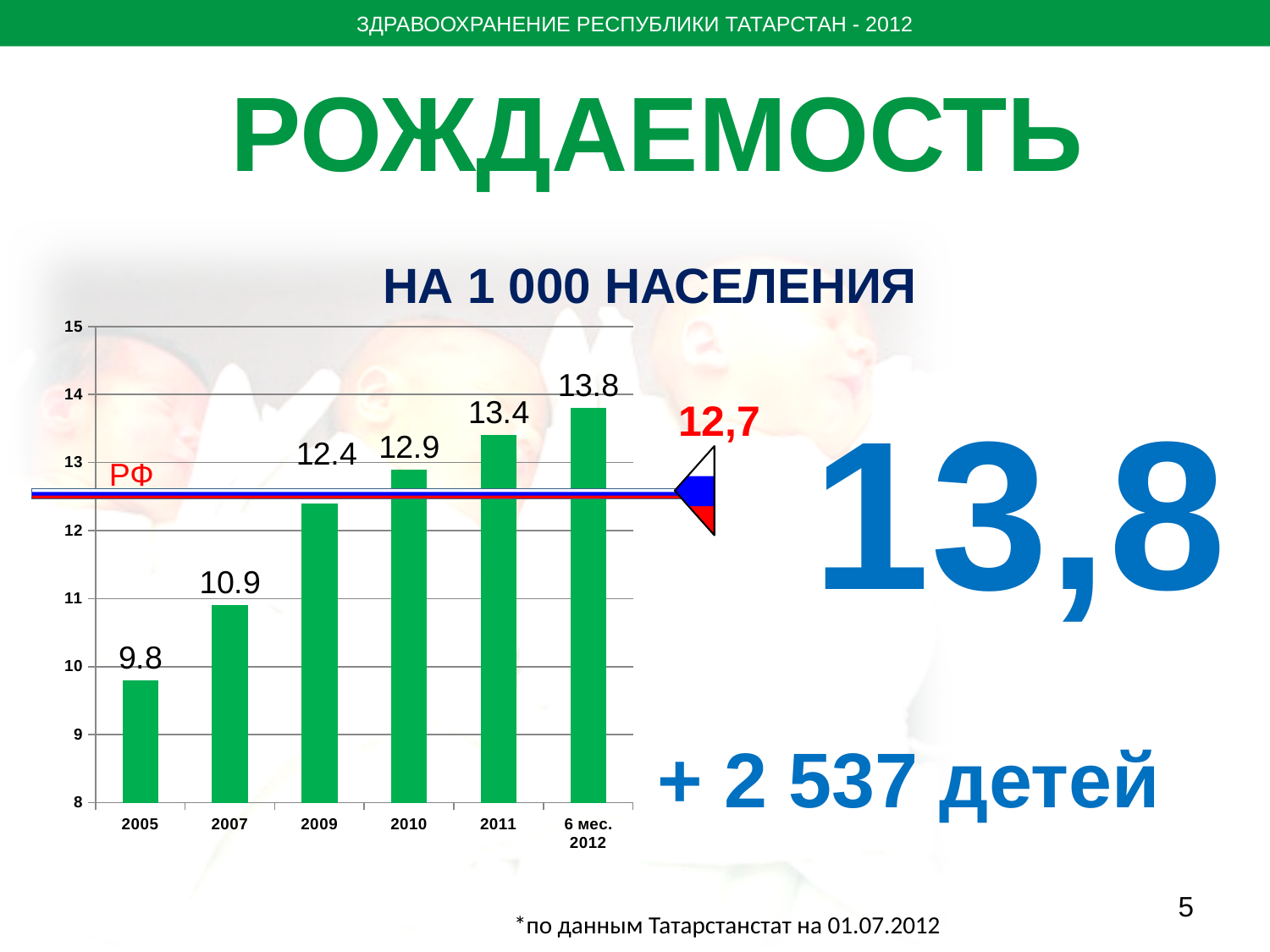
What value is shown for 2011? 13.4 How many bars are plotted on the chart? 6 What is the difference between the values for 6 мес. 2012 and 2005? 4.0 Which is larger, the value for 2007 or the value for 2009? 2009 Which year has the lowest value on the chart? 2005 What is the difference between the values for 2010 and 2009? 0.5 What value is marked for the РФ reference line on the chart? 12,7 Do the values rise or fall from 2005 to 6 мес. 2012? rise What kind of chart is shown on the slide? bar chart What value is shown for 6 мес. 2012? 13.8 Which category has the highest value on the chart? 6 мес. 2012 What is the birth rate per 1,000 population shown for 2005? 9.8